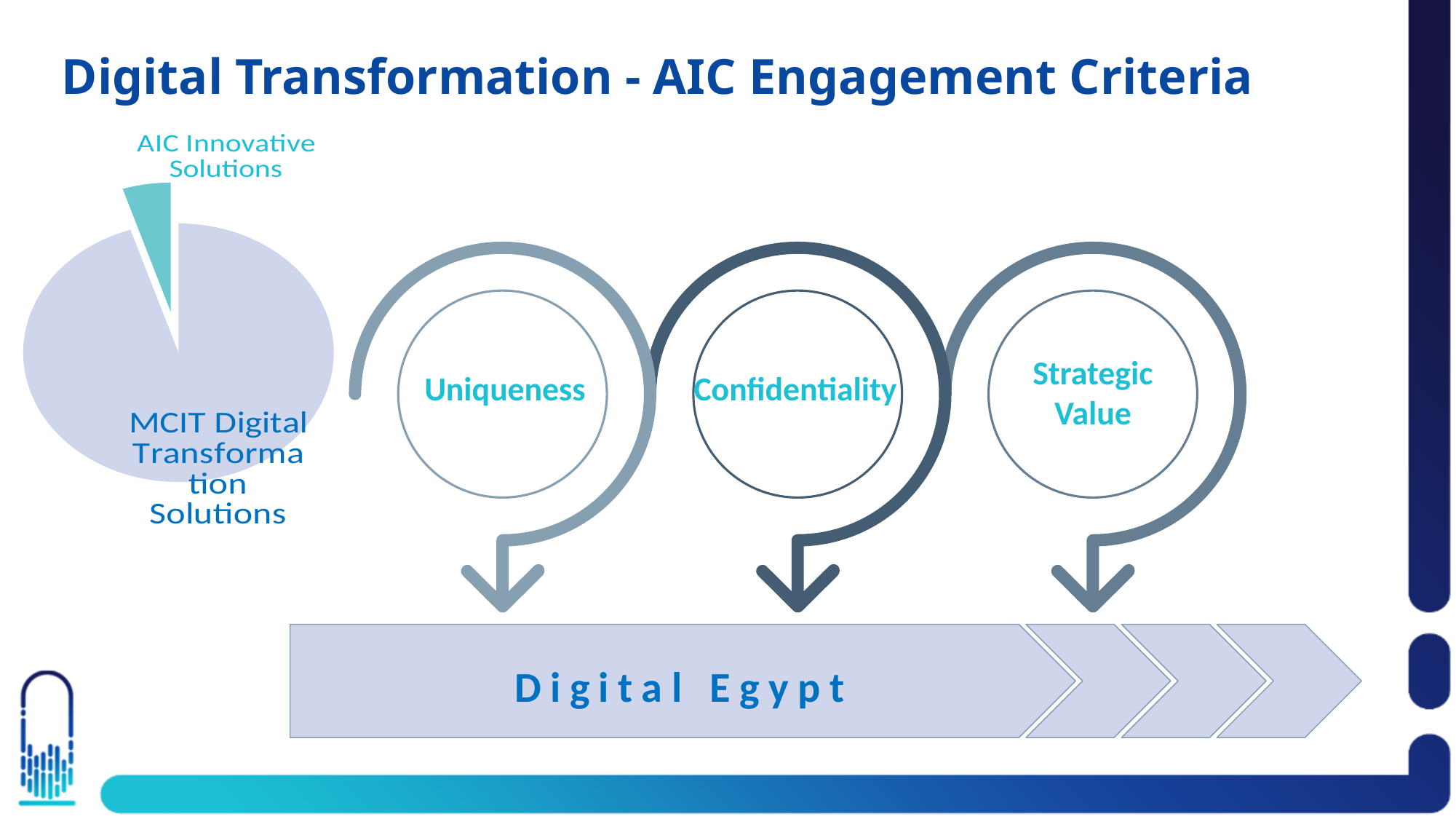
Which slice of the pie chart is the largest? MCIT Digital Transformation Solutions In the pie chart, which is larger: the AIC Innovative Solutions slice or the MCIT Digital Transformation Solutions slice? MCIT Digital Transformation Solutions What kind of chart is shown on the left of the slide? pie chart Which slice of the pie chart is pulled out (exploded) from the rest of the pie? AIC Innovative Solutions Which slice of the pie chart is the smallest? AIC Innovative Solutions What colour is the AIC Innovative Solutions slice in the pie chart? teal How many slices does the pie chart have? 2